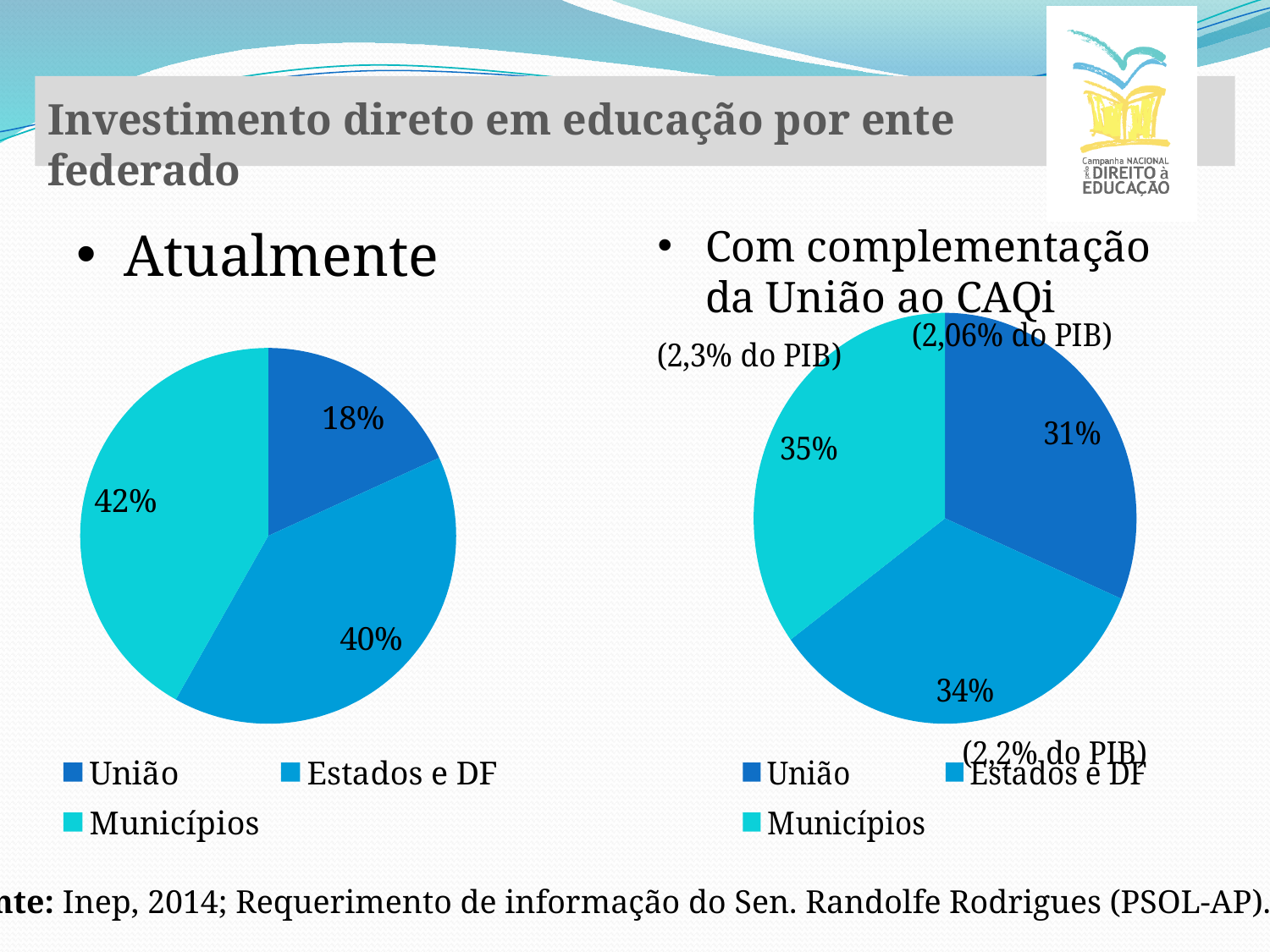
How many categories does each pie chart show? 3 In the left pie chart (Atualmente), what share do Municípios have? 42% In the left pie chart (Atualmente), what is the difference between the shares of Estados e DF and União? 22% In the right pie chart (Com complementação da União ao CAQi), what is the difference between the shares of Municípios and União? 4% In the left pie chart (Atualmente), which category has the largest share? Municípios In the left pie chart (Atualmente), which category has the smallest share? União In the right pie chart (Com complementação da União ao CAQi), which category has the smallest share? União Which is larger: the share of União in the left chart (Atualmente) or in the right chart (Com complementação da União ao CAQi)? Right chart (31%) What type of chart is used on this slide? Pie chart In the right pie chart (Com complementação da União ao CAQi), what share does União have? 31% In the left pie chart (Atualmente), what share does União have? 18% In the right pie chart (Com complementação da União ao CAQi), what share do Estados e DF have? 34%